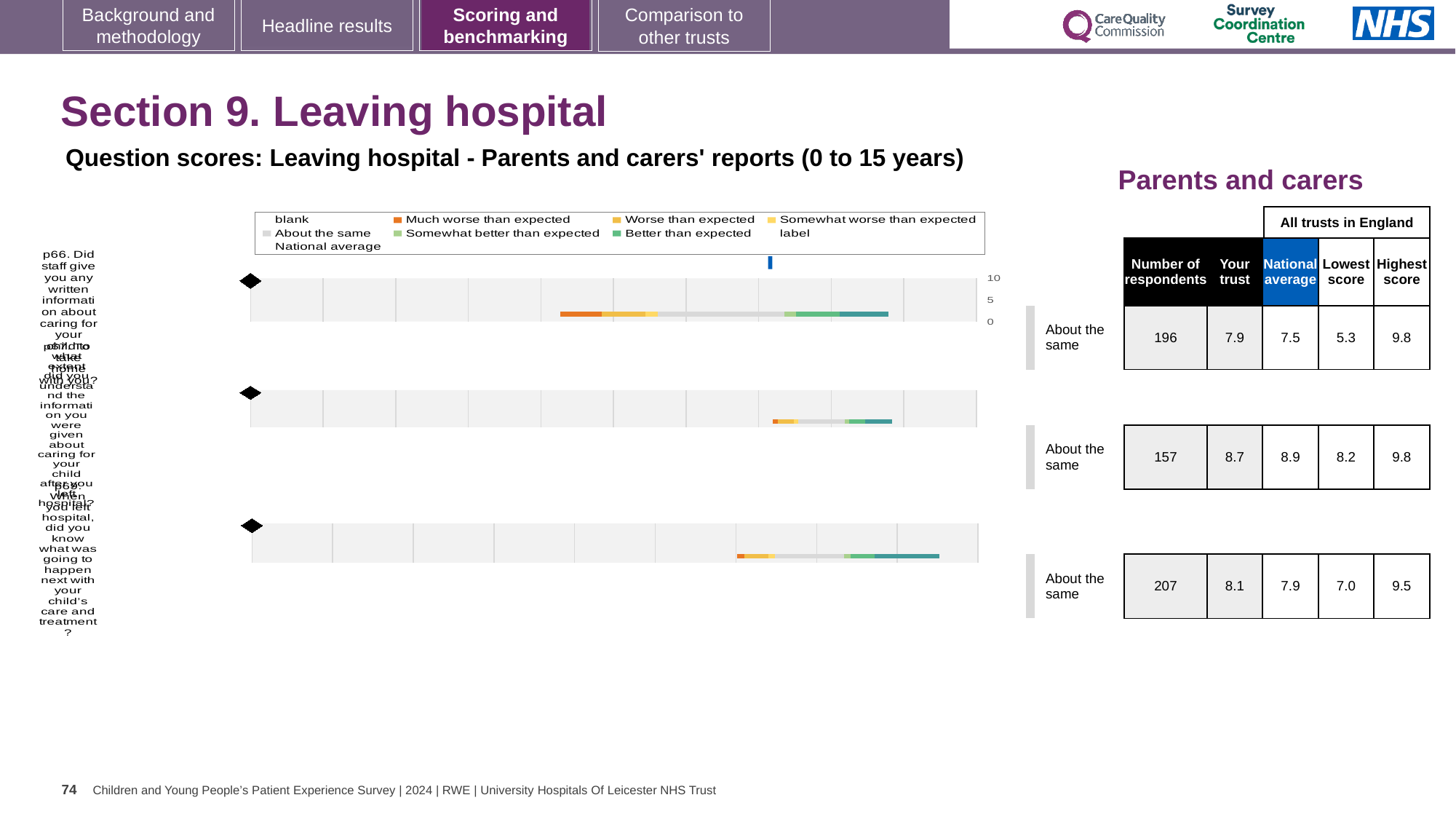
What is the highest score across all trusts in England for the middle chart row? 9.8 What is the number of respondents for the bottom chart row (p68)? 207 What is the difference between the 'Your trust' score and the national average for the top chart row (p66)? 0.4 What is the 'Your trust' score for the bottom chart row (p68, did you know what was going to happen next)? 8.1 How many question score charts (rows) are shown on the slide? 3 In the legend, which colour represents 'Much worse than expected'? orange For the middle chart row, is the 'Your trust' score or the national average larger? national average What is the 'Your trust' score for the top chart row (p66, written information about caring for your child)? 7.9 Which chart row has the lowest 'Lowest score' value across all trusts in England? the top row (p66), 5.3 What is the national average for the top chart row (p66)? 7.5 What kind of chart is used to show the question scores on this slide? bar chart What benchmark category is the trust placed in for all three chart rows? About the same